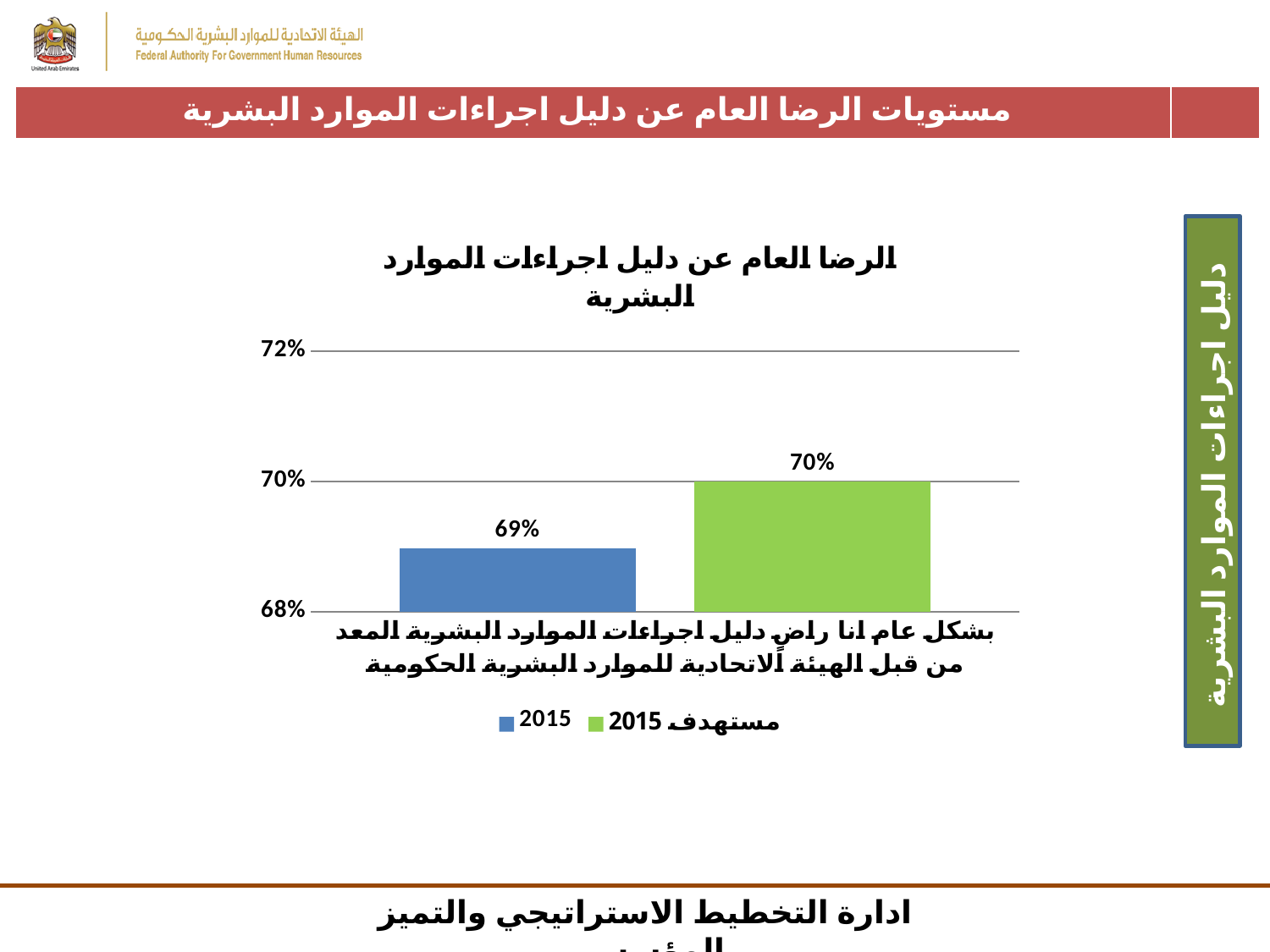
Which series has the higher value, 2015 or مستهدف 2015? مستهدف 2015 How many bars are plotted in the chart? 2 What kind of chart is shown on the slide? bar chart Is the value for مستهدف 2015 greater or less than 72%? less What colour is the bar for مستهدف 2015? green Is the 2015 value larger or smaller than the مستهدف 2015 value? smaller What is the value of the 2015 bar? 69% What is the difference between the مستهدف 2015 value and the 2015 value? 1% What is the value of the مستهدف 2015 (target 2015) bar? 70% Which series has the lower value, 2015 or مستهدف 2015? 2015 How many series does the legend list? 2 Is the value for 2015 greater or less than 70%? less